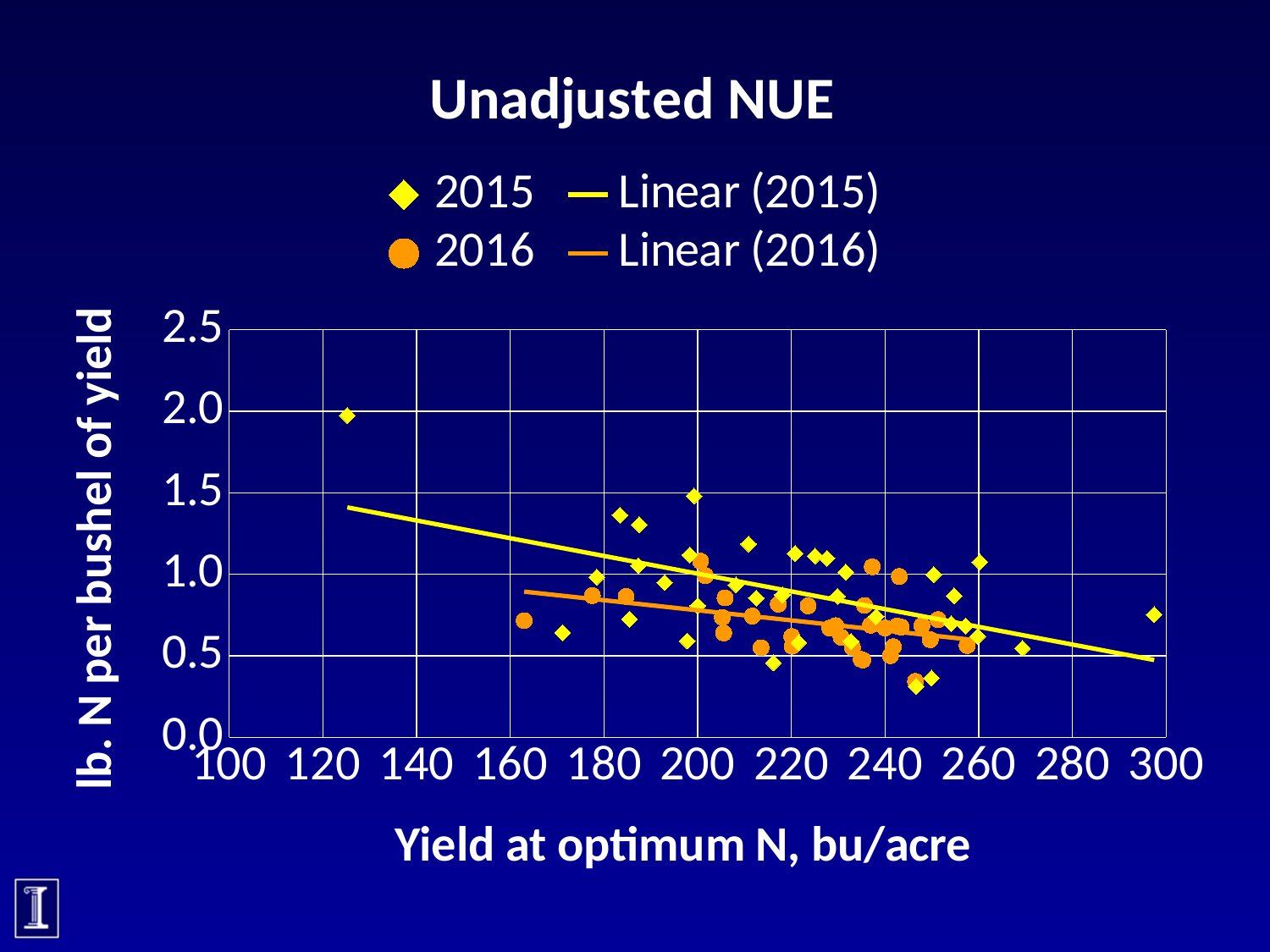
Does the Linear (2016) trendline rise or fall as yield increases along the x axis? fall What is the title of the chart? Unadjusted NUE How many entries does the chart legend list? 4 Does the Linear (2015) trendline rise or fall as yield increases along the x axis? fall Is the value of the leftmost 2015 point (near 125 bu/acre) greater or less than 1.5 lb. N per bushel? greater Which series contains the highest plotted point in the chart? 2015 How many years of data are plotted as points in the chart? 2 What kind of chart is shown on the slide? scatter chart Is the value of the leftmost 2016 point (near 163 bu/acre) greater or less than 1.0 lb. N per bushel? less Is the value of the rightmost 2015 point (near 297 bu/acre) greater or less than 1.0 lb. N per bushel? less What is the x-axis title of the chart? Yield at optimum N, bu/acre At a yield of 200 bu/acre, which trendline is higher, Linear (2015) or Linear (2016)? Linear (2015)